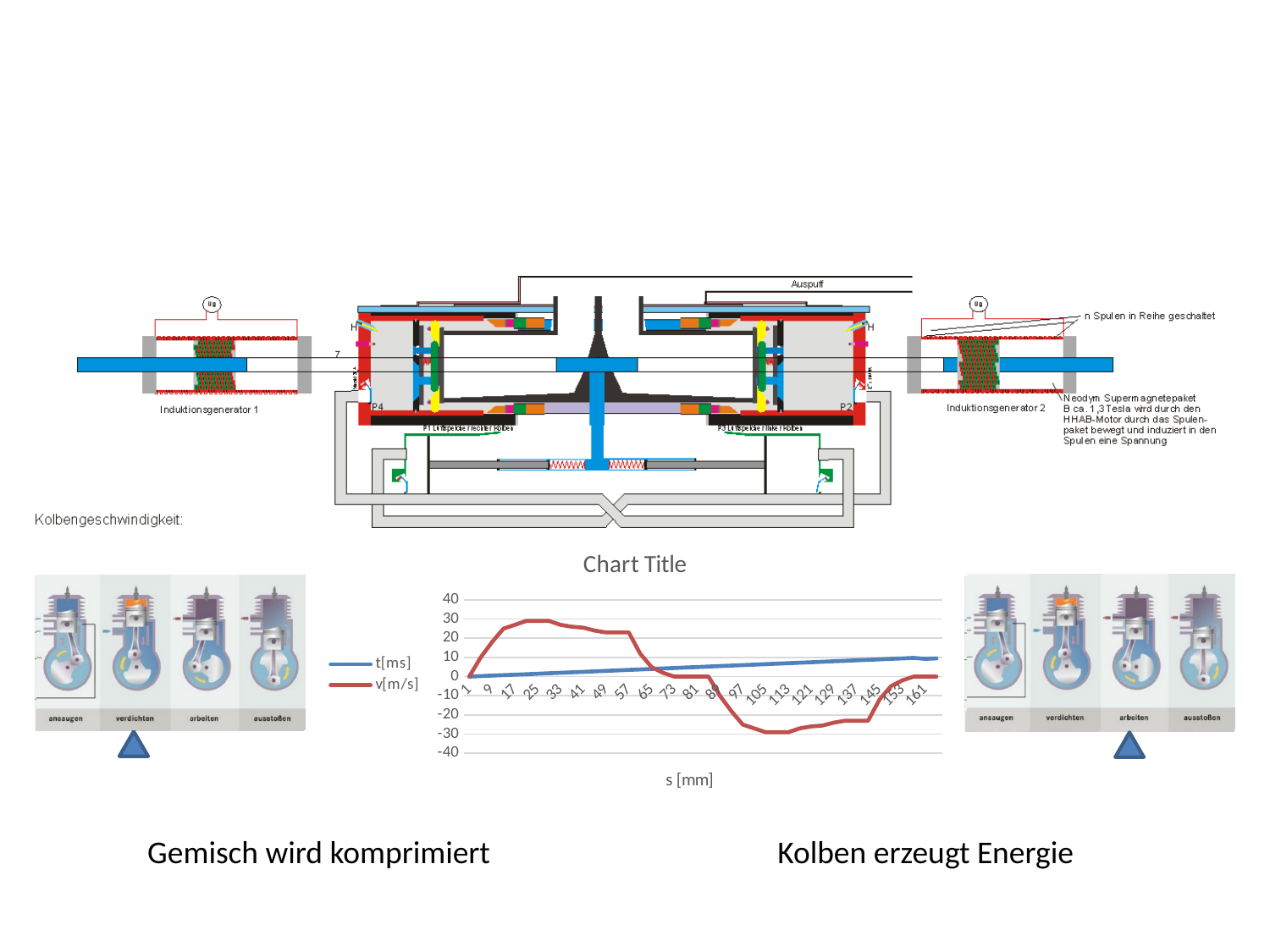
Is the value of v[m/s] at s = 105 greater or less than -20? less Which series reaches the highest value on the chart? v[m/s] What kind of chart is shown on the slide? line chart Is the value of t[ms] at s = 81 greater or less than 10? less What are the two series named in the chart legend? t[ms] and v[m/s] At s = 105, which series has the larger value, t[ms] or v[m/s]? t[ms] Does the t[ms] series rise or fall along the x axis? rise What is the label of the x axis of the chart? s [mm] How many series does the chart legend list? 2 At s = 25, which series has the larger value, t[ms] or v[m/s]? v[m/s] Is the value of v[m/s] at s = 25 greater or less than 20? greater Which series reaches the lowest value on the chart? v[m/s]